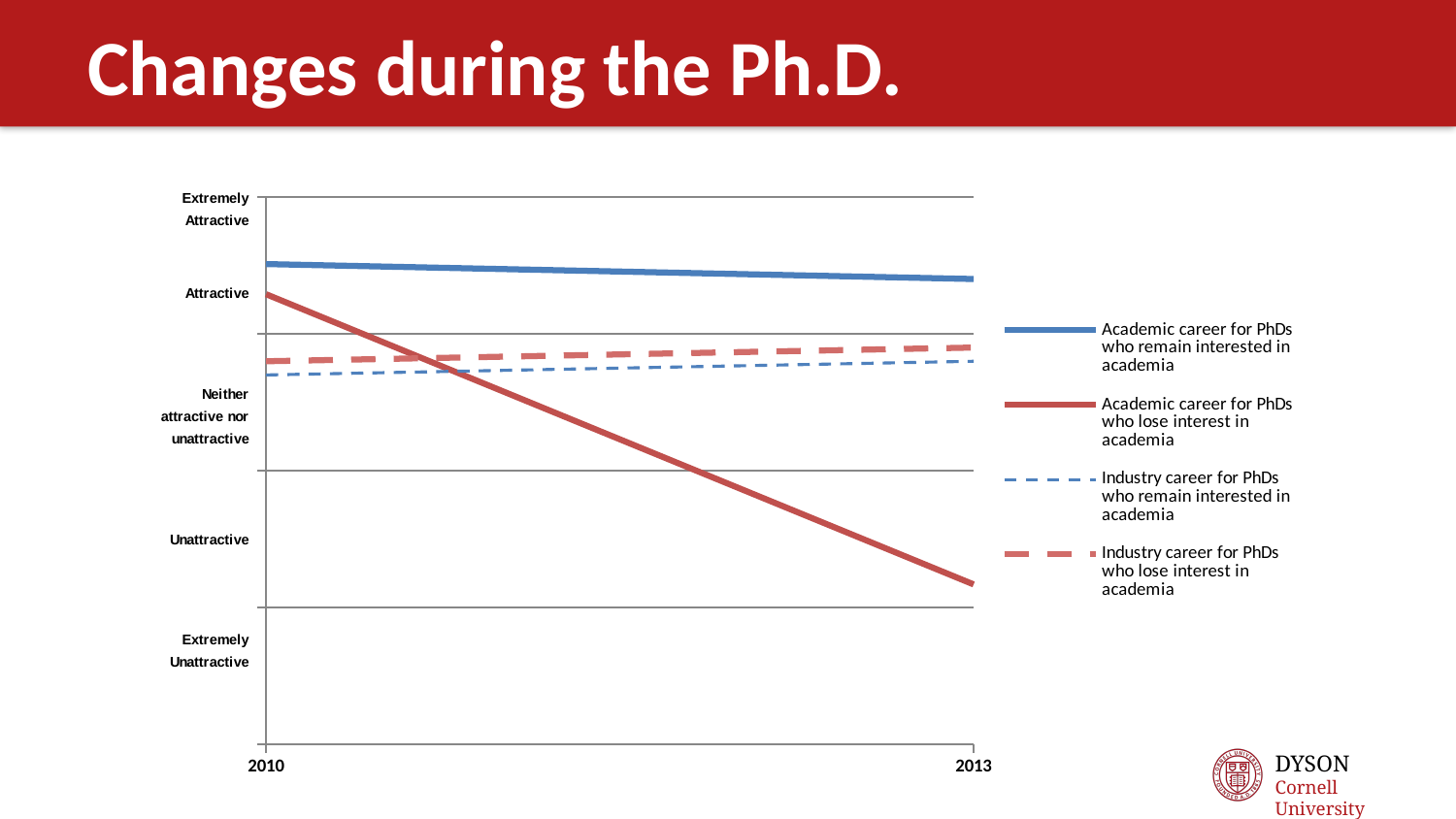
How many series does the legend list? 4 In 2010, which is higher: 'Academic career for PhDs who lose interest in academia' or 'Industry career for PhDs who lose interest in academia'? Academic career for PhDs who lose interest in academia Is the 2013 value for 'Academic career for PhDs who lose interest in academia' above or below the 'Neither attractive nor unattractive' level? Below What is the title of the slide containing the chart? Changes during the Ph.D. Does the line for 'Academic career for PhDs who lose interest in academia' rise or fall from 2010 to 2013? Fall How many years are shown on the x axis? 2 What kind of chart is shown on the slide? Line chart Does the line for 'Academic career for PhDs who remain interested in academia' rise or fall from 2010 to 2013? Fall Does the line for 'Industry career for PhDs who lose interest in academia' rise or fall from 2010 to 2013? Rise Which years are shown on the x axis? 2010 and 2013 Which series has the highest value in 2013? Academic career for PhDs who remain interested in academia Which series has the lowest value in 2013? Academic career for PhDs who lose interest in academia